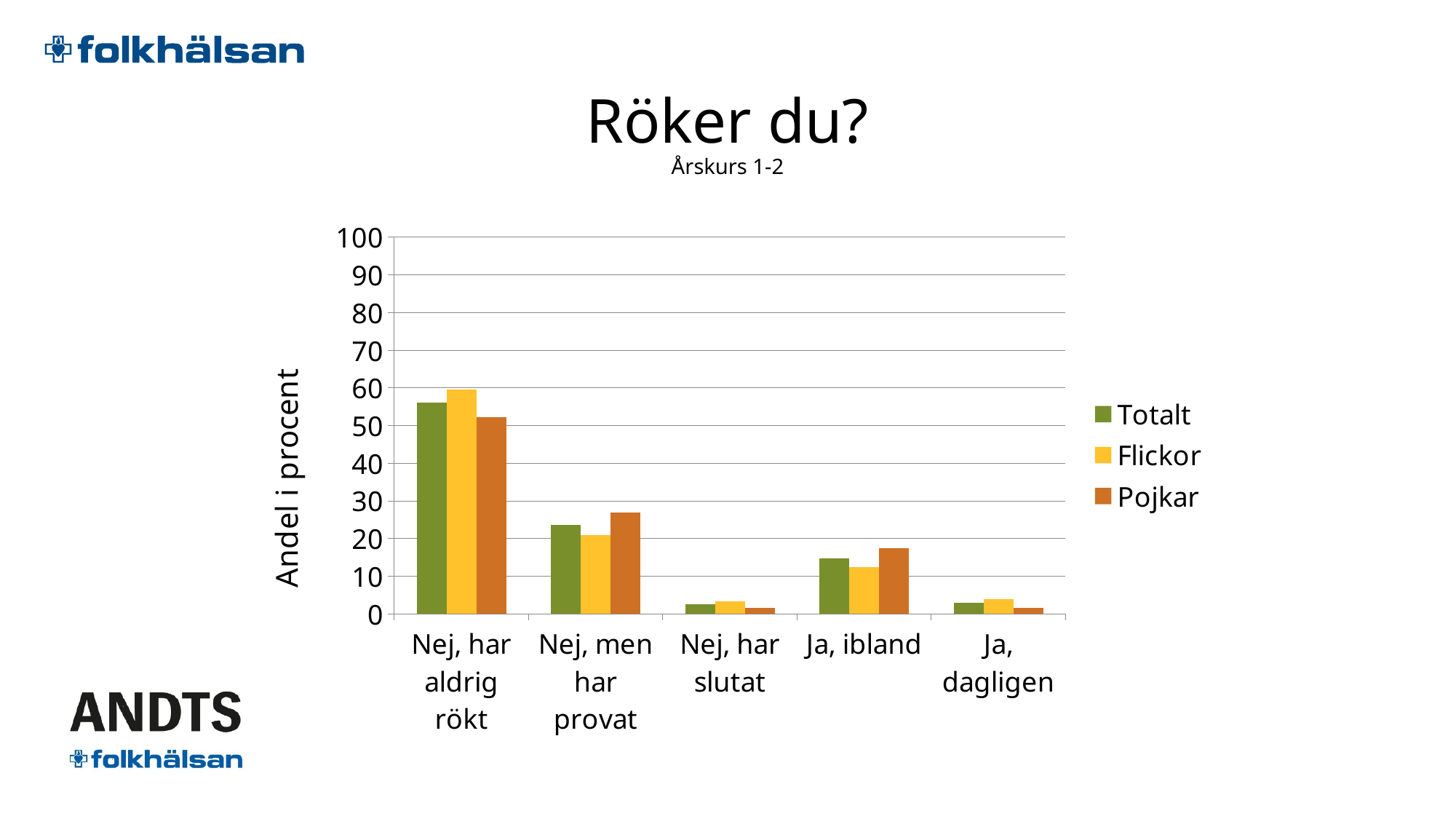
In the category "Nej, har aldrig rökt", which series has the highest bar? Flickor In the category "Ja, ibland", which series has the highest bar? Pojkar How many series does the legend list? 3 Is the value for Flickor in "Nej, har aldrig rökt" greater or less than 50? greater Is the value for Pojkar in "Nej, men har provat" greater or less than 30? less For the Totalt series, which category has the highest value? Nej, har aldrig rökt How many answer categories are shown on the x axis? 5 What are the three legend entries? Totalt, Flickor, Pojkar In the category "Nej, men har provat", which is larger: Pojkar or Flickor? Pojkar What is the title of the y axis? Andel i procent Is the value for Totalt in "Ja, ibland" greater or less than 10? greater What kind of chart is shown on the slide? bar chart